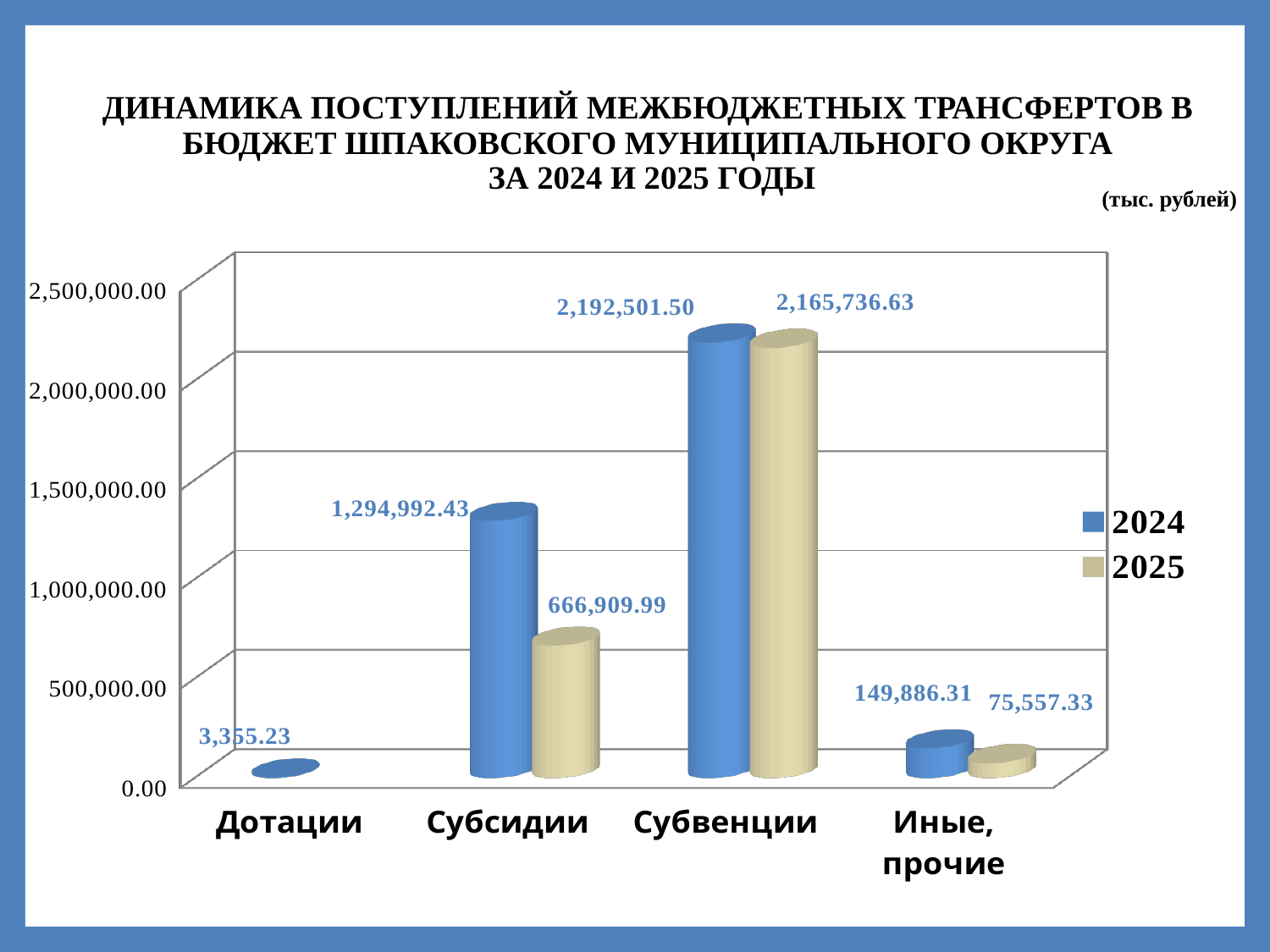
Which category has the lowest value in the 2024 series? Дотации What is the value for Дотации in the 2024 series? 3,355.23 How many series does the legend list? 2 What is the value for Иные, прочие in the 2025 series? 75,557.33 Which is larger for Субсидии: the 2024 value or the 2025 value? 2024 What is the difference between the 2024 and 2025 values for Субсидии? 628,082.44 What is the value for Субсидии in the 2024 series? 1,294,992.43 What is the difference between the 2024 and 2025 values for Иные, прочие? 74,328.98 What is the value for Субвенции in the 2025 series? 2,165,736.63 What kind of chart is shown on the slide? Bar chart How many categories are shown on the x axis? 4 Which category has the highest value in the 2024 series? Субвенции